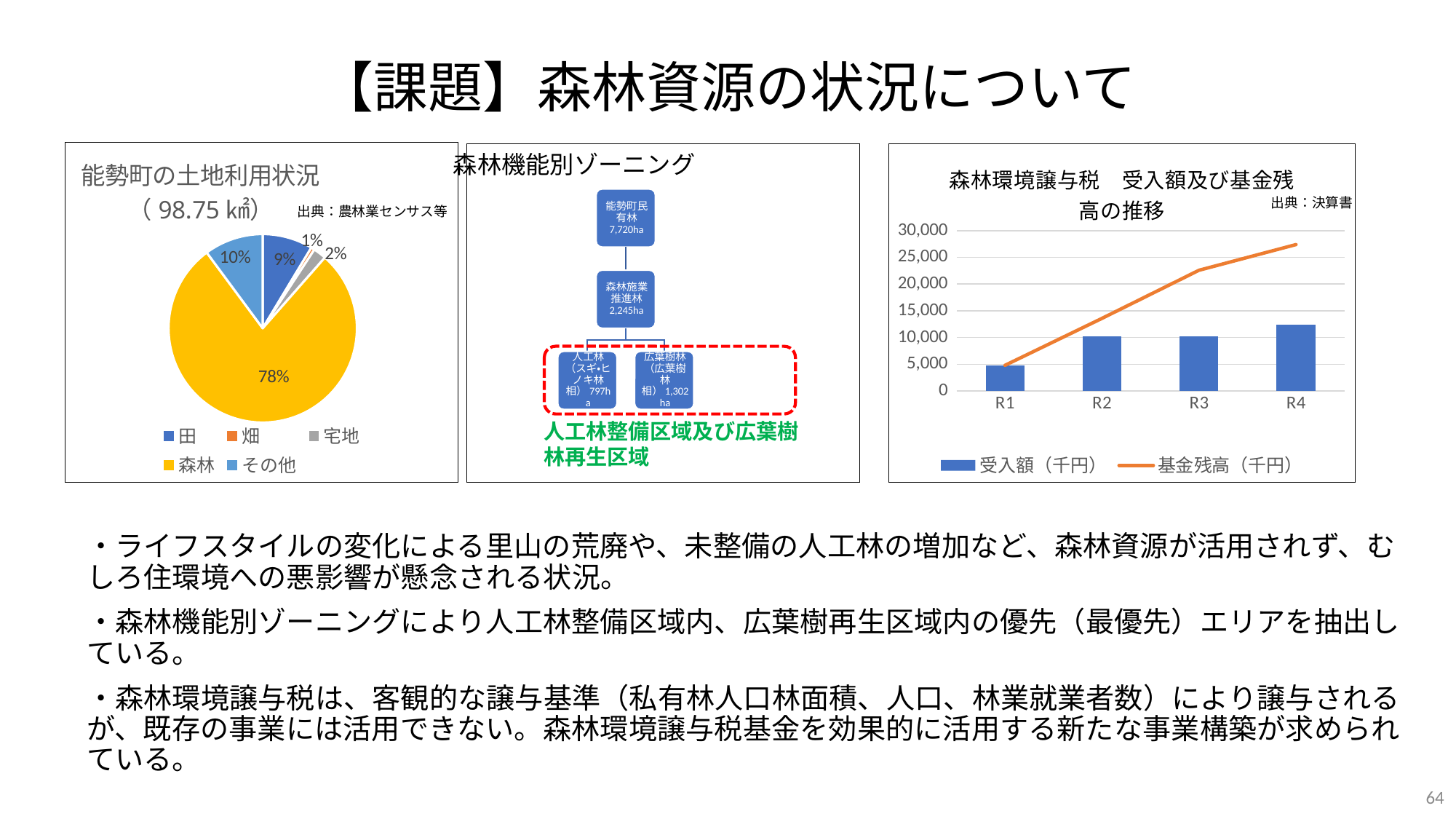
In the chart 森林環境譲与税 受入額及び基金残高の推移, does 基金残高 rise or fall from R1 to R4? Rises In the pie chart 能勢町の土地利用状況, what percentage is shown for 田? 9% In the pie chart 能勢町の土地利用状況, what is the difference in percentage points between 森林 and その他? 68% In the pie chart 能勢町の土地利用状況, which category has the largest share? 森林 In the chart 森林環境譲与税 受入額及び基金残高の推移, is the 基金残高 value for R4 greater or less than 25,000? greater In the pie chart 能勢町の土地利用状況, what share does 森林 have? 78% In the chart 森林環境譲与税 受入額及び基金残高の推移, which year has the highest 受入額 bar? R4 In the pie chart 能勢町の土地利用状況, how many categories does the legend list? 5 In the chart 森林環境譲与税 受入額及び基金残高の推移, how many years are shown on the x axis? 4 In the pie chart 能勢町の土地利用状況, what percentage is shown for その他? 10% In the chart 森林環境譲与税 受入額及び基金残高の推移, how many series does the legend list? 2 What kind of chart is 能勢町の土地利用状況? Pie chart